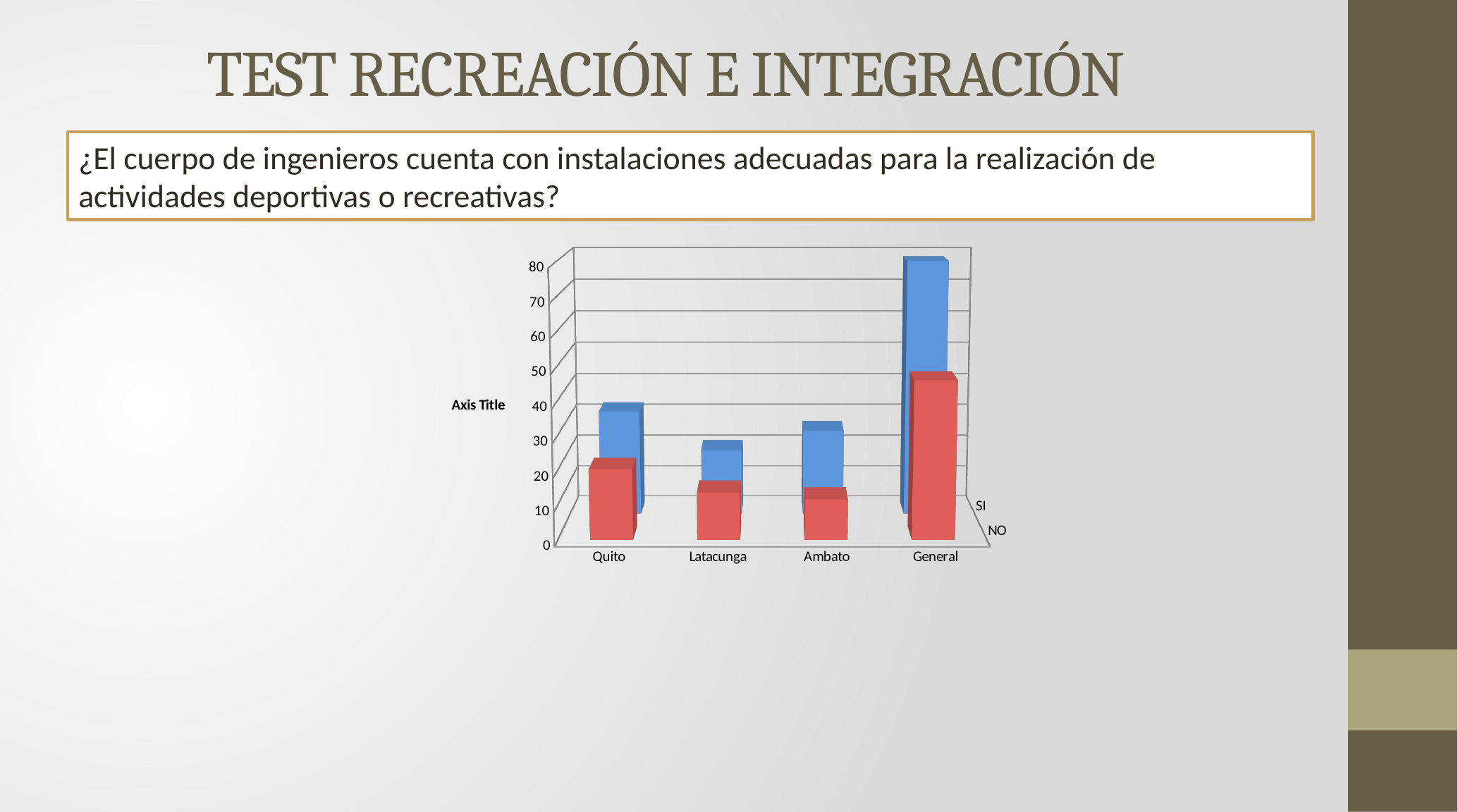
What colour are the bars for the SI series? blue Which category has the highest NO value? General How many data series does the chart show? 2 Is the SI value for Quito greater or less than 50? less What kind of chart is shown on the slide? bar chart Which category has the lowest SI value? Latacunga Is the SI value for General greater or less than 70? greater For General, which is larger, the SI value or the NO value? SI Is the NO value for Latacunga greater or less than 30? less Which category has the highest SI value? General For Quito, which is larger, the SI value or the NO value? SI How many categories are shown on the x axis of the chart? 4